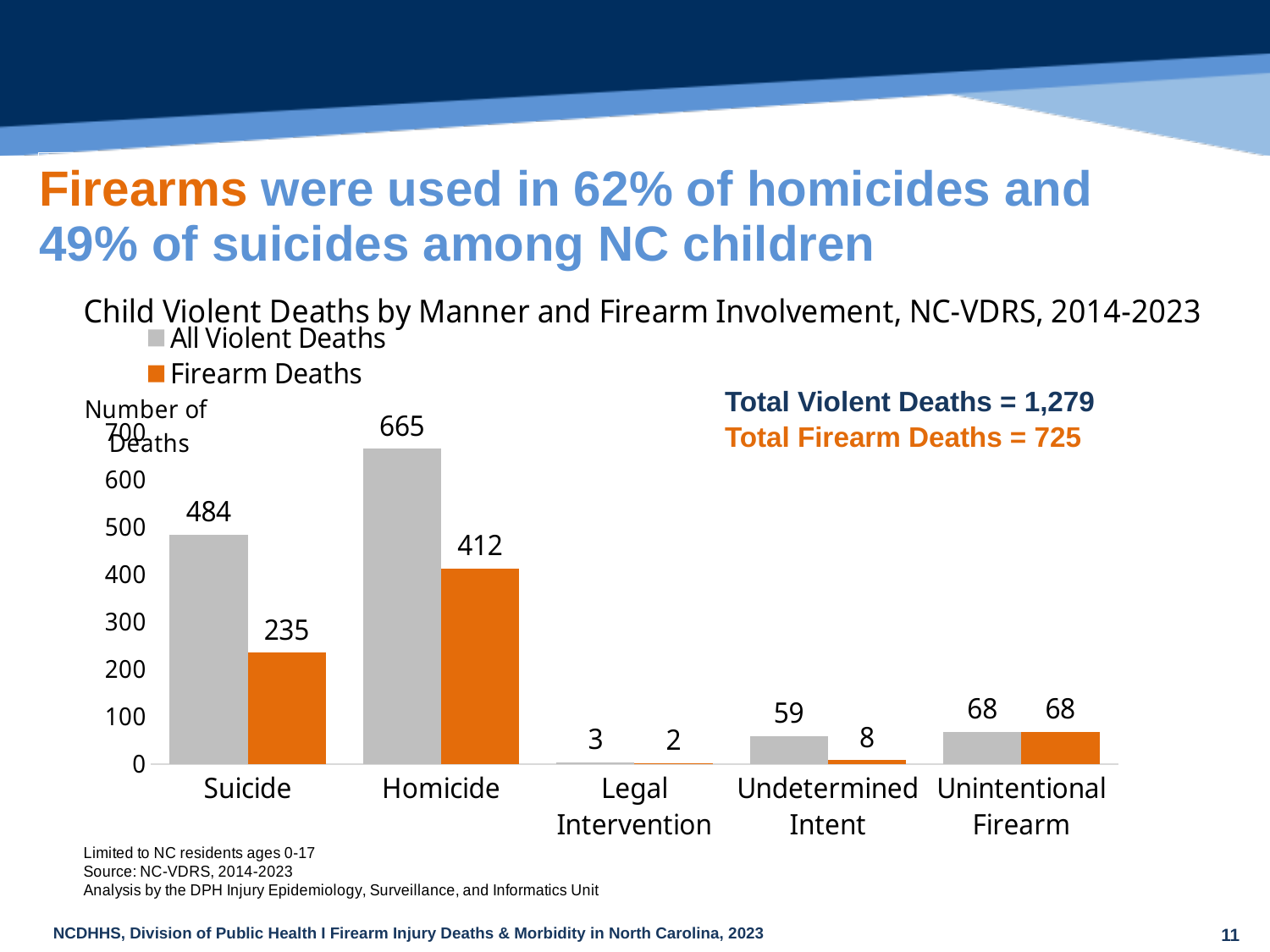
What is the number of All Violent Deaths for Homicide? 665 What kind of chart is shown on the slide? Bar chart How many categories are shown on the x axis? 5 Which category has the lowest number of Firearm Deaths? Legal Intervention What is the title of the chart? Child Violent Deaths by Manner and Firearm Involvement, NC-VDRS, 2014-2023 What is the difference between All Violent Deaths and Firearm Deaths for Suicide? 249 What is the number of Firearm Deaths for Suicide? 235 How many series does the legend list? 2 What is the number of Firearm Deaths for Undetermined Intent? 8 Which category has the highest number of All Violent Deaths? Homicide What is the difference between All Violent Deaths for Homicide and All Violent Deaths for Suicide? 181 Which is larger: Firearm Deaths for Homicide or All Violent Deaths for Suicide? All Violent Deaths for Suicide